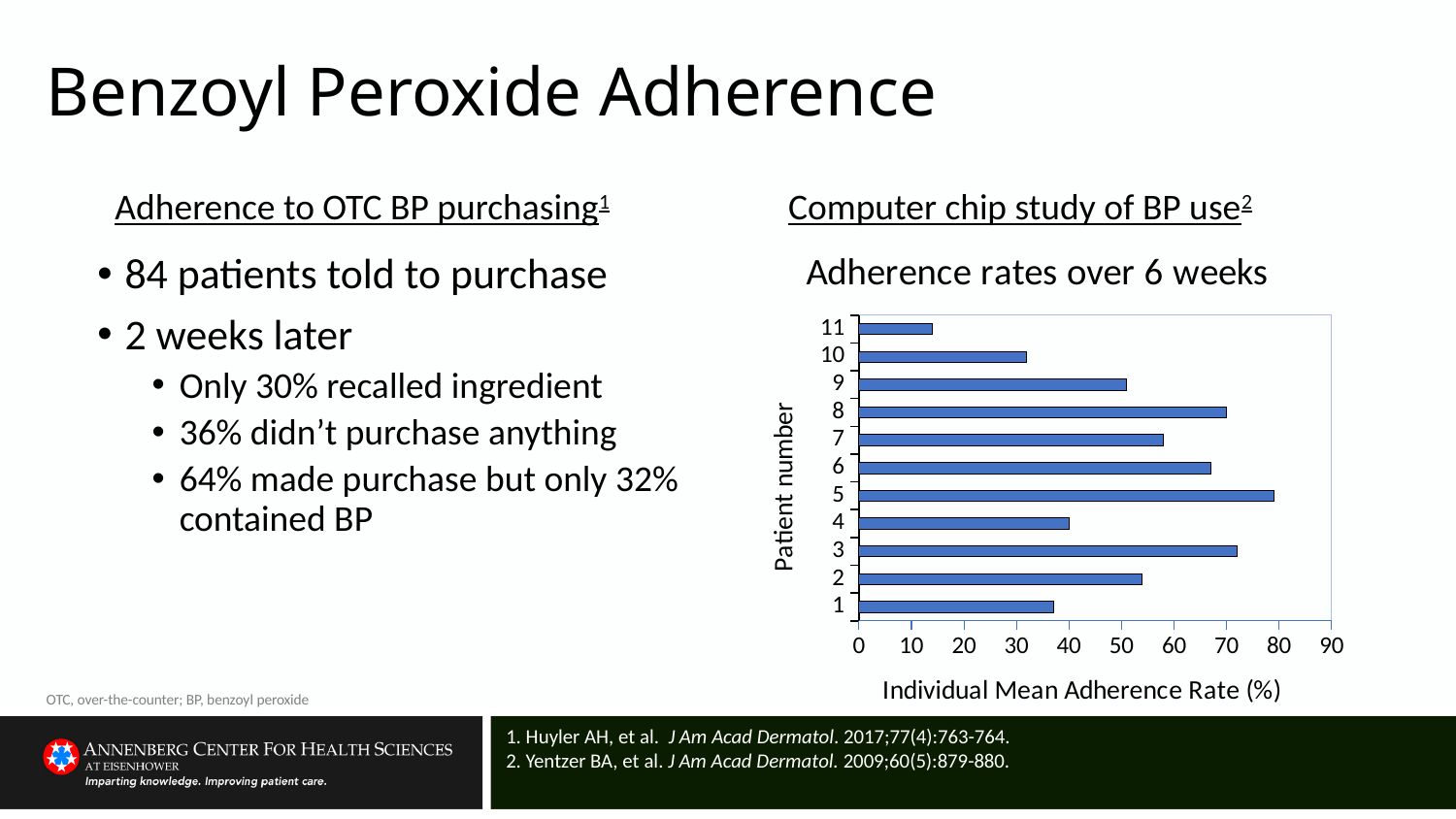
Is the adherence rate for patient 5 greater or less than 70? greater What is the label of the horizontal axis of the chart? Individual Mean Adherence Rate (%) Which patient number has the highest individual mean adherence rate? 5 Which has a higher adherence rate, patient 8 or patient 4? Patient 8 Is the adherence rate for patient 11 greater or less than 20? less Is the adherence rate for patient 4 greater or less than 50? less How many patients are plotted in the chart? 11 Which has a higher adherence rate, patient 9 or patient 10? Patient 9 Which patient number has the lowest individual mean adherence rate? 11 What kind of chart is shown on the slide? Bar chart